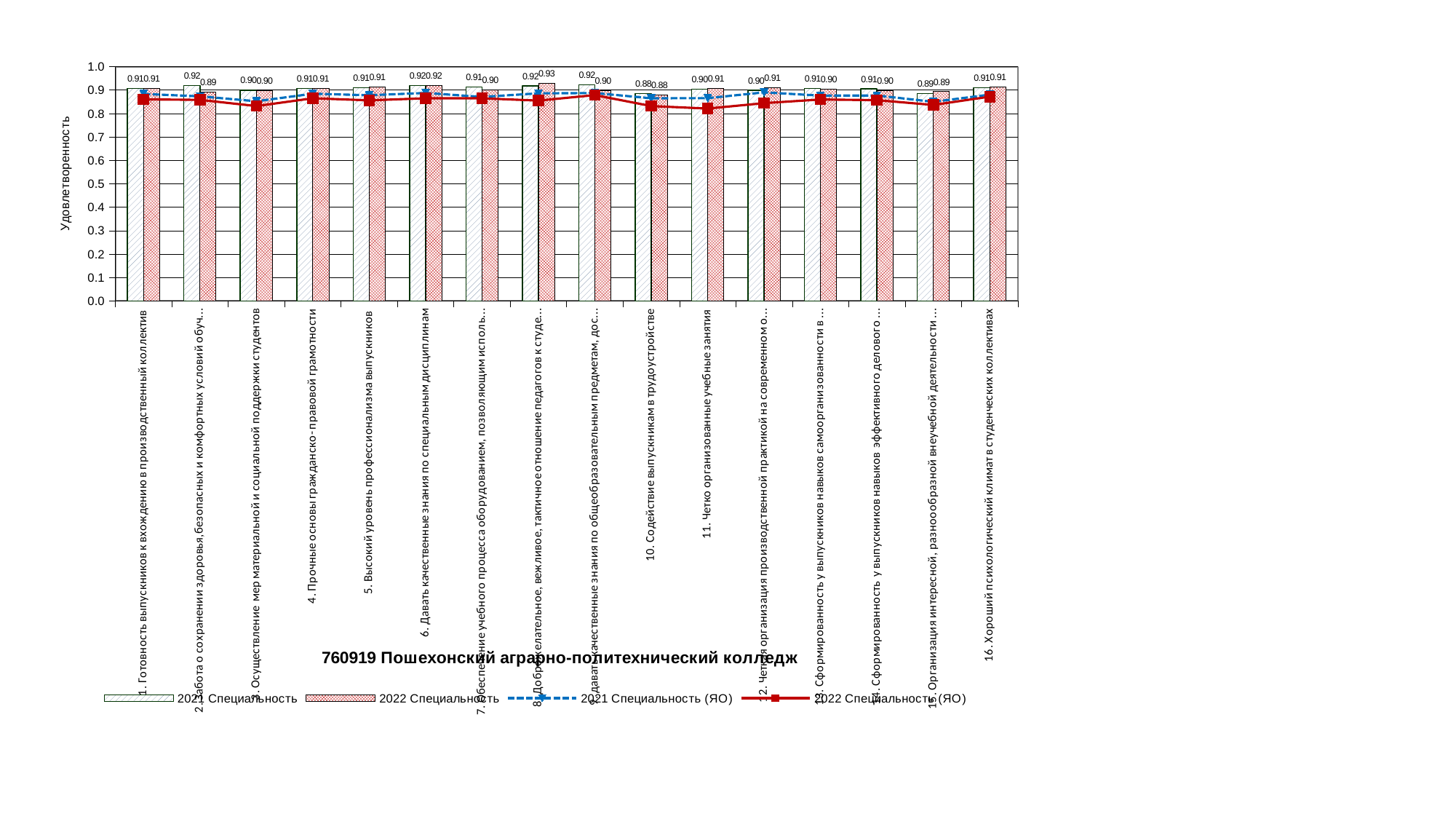
What is the title of the chart? 760919 Пошехонский аграрно-политехнический колледж Is the 2022 Специальность (ЯО) line value for category 11 (Четко организованные учебные занятия) greater or less than 0.9? less Which category has the lowest 2022 Специальность bar? 10 (Содействие выпускникам в трудоустройстве) For category 2, which is larger: the 2021 Специальность bar or the 2022 Специальность bar? 2021 Специальность What is the difference between the 2021 and 2022 Специальность values for category 2? 0.03 What is the 2022 Специальность value for category 16 (Хороший психологический климат в студенческих коллективах)? 0.91 Which category has the highest 2022 Специальность bar? 8 What is the 2021 Специальность value for category 6 (Давать качественные знания по специальным дисциплинам)? 0.92 What is the 2021 Специальность value for category 10 (Содействие выпускникам в трудоустройстве)? 0.88 What is the 2022 Специальность value for category 3 (Осуществление мер материальной и социальной поддержки студентов)? 0.90 How many series does the legend list? 4 How many categories are shown on the x axis? 16